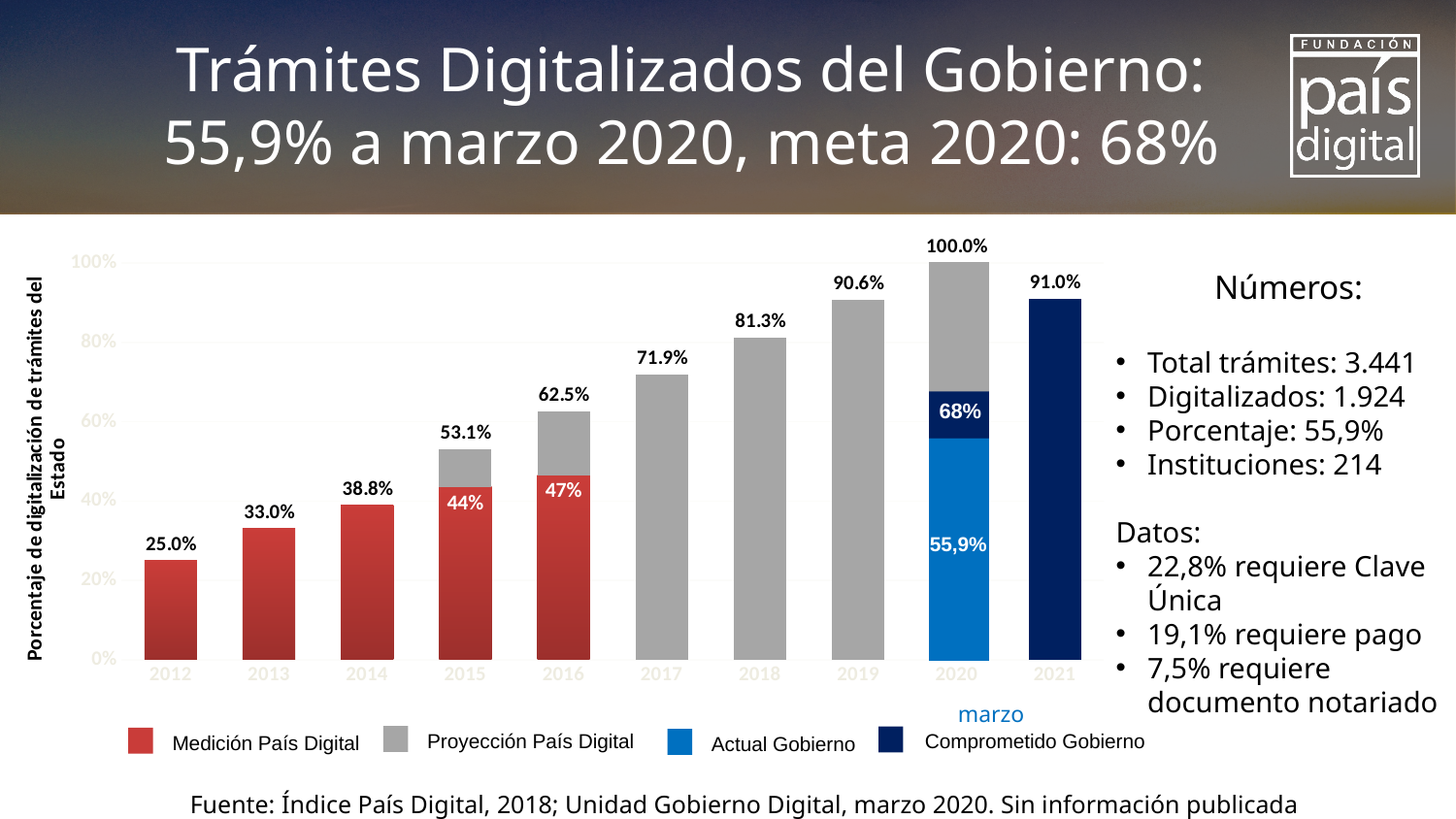
What is the difference between the 2013 value and the 2012 value? 8.0% What is the Comprometido Gobierno value shown inside the 2020 bar? 68% What is the value labeled for 2021? 91.0% How many years are shown on the x axis? 10 Which year has the lowest value? 2012 Which is larger, the value labeled for 2018 or the value labeled for 2017? 2018 What is the Medición País Digital value labeled inside the 2015 bar? 44% What is the Actual Gobierno value shown inside the 2020 bar? 55,9% What is the value labeled for 2012? 25.0% Which year has the tallest bar? 2020 How many series does the legend list? 4 What value is labeled at the top of the 2019 bar? 90.6%